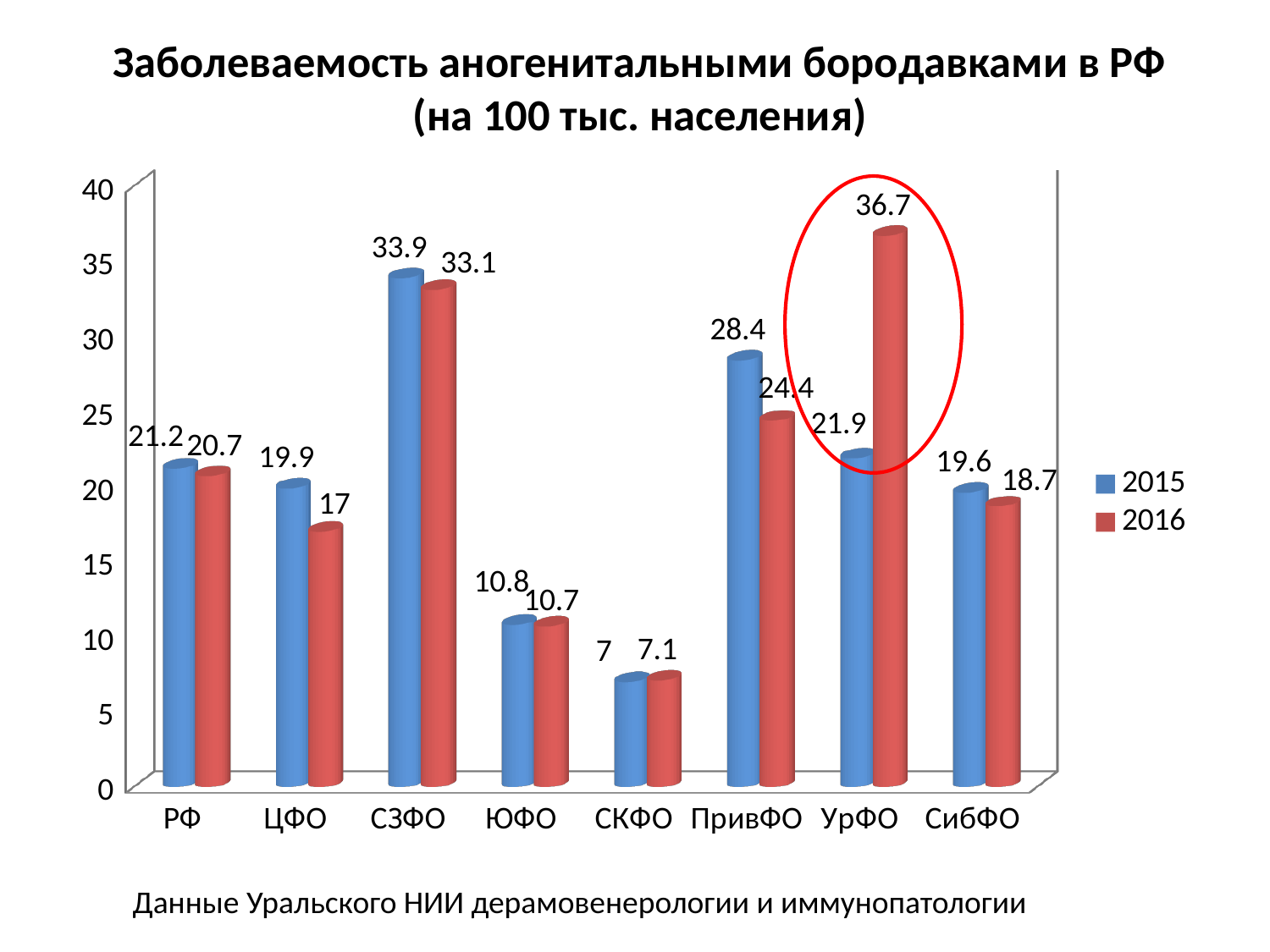
Which is larger for ПривФО, the 2015 value or the 2016 value? 2015 How many series does the legend list? 2 What is the 2015 value for СЗФО? 33.9 What is the 2016 value for ЦФО? 17 What is the difference between the 2015 and 2016 values for РФ? 0.5 What kind of chart is shown on the slide? Bar chart How many categories are shown on the x axis? 8 What is the 2016 value for УрФО? 36.7 Which category has the lowest 2016 value? СКФО What is the difference between the 2016 and 2015 values for УрФО? 14.8 Which category has the highest 2015 value? СЗФО Which category is highlighted with a red ellipse? УрФО